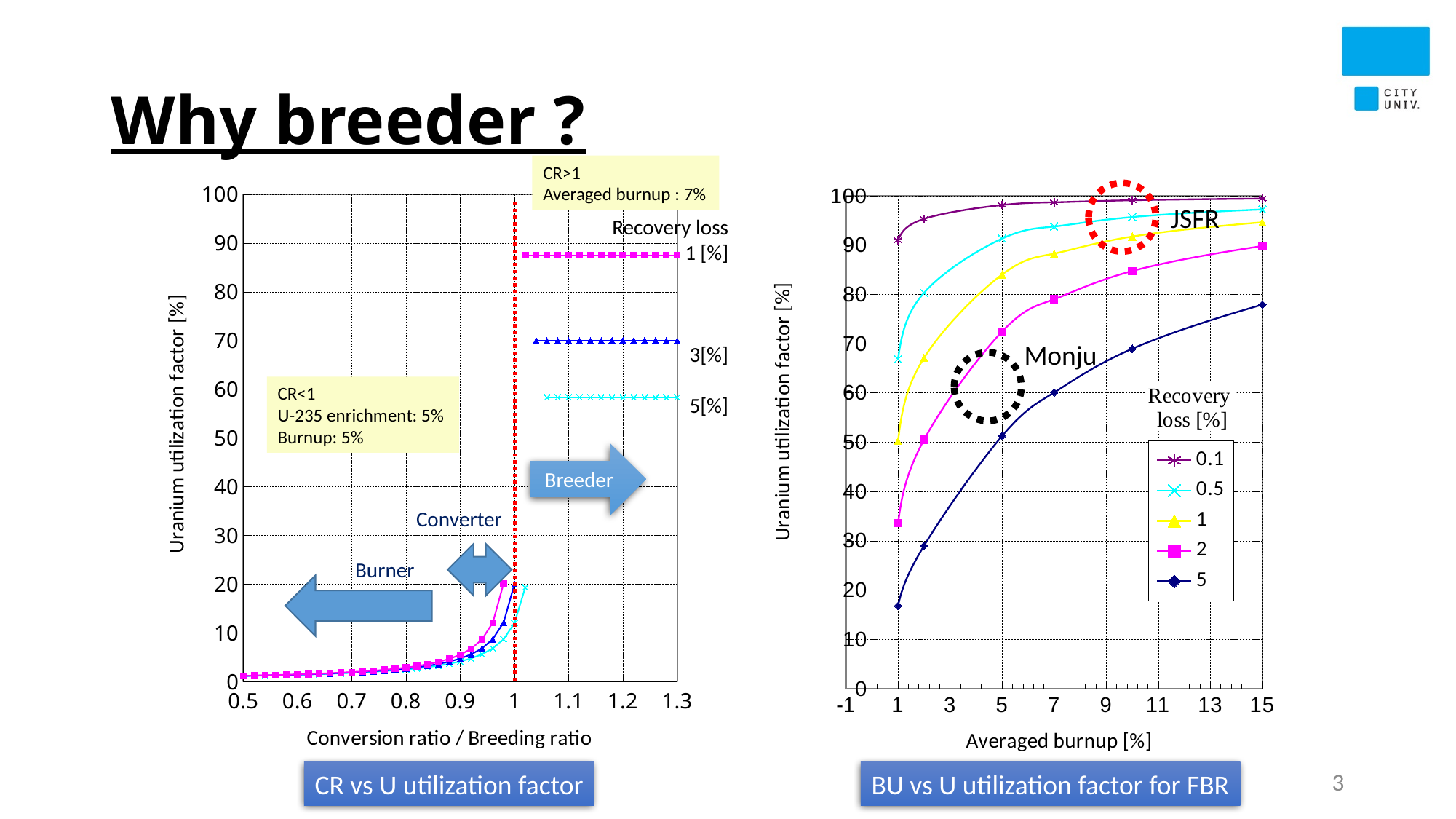
In the 'BU vs U utilization factor for FBR' chart, is the value for recovery loss 5 at an averaged burnup of 1% greater or less than 20? less In the 'BU vs U utilization factor for FBR' chart, is the value for recovery loss 5 at an averaged burnup of 15% greater or less than 70? greater In the 'CR vs U utilization factor' chart, is the uranium utilization factor for recovery loss 1 [%] in the breeder region (CR>1) greater or less than 80? greater What kind of chart is the 'CR vs U utilization factor' chart on the left? line chart In the 'CR vs U utilization factor' chart, how many recovery loss series are plotted? 3 What is the x-axis title of the 'CR vs U utilization factor' chart? Conversion ratio / Breeding ratio How many series does the legend of the 'BU vs U utilization factor for FBR' chart list? 5 In the 'BU vs U utilization factor for FBR' chart, at an averaged burnup of 5%, which series has the larger uranium utilization factor: recovery loss 0.5 or recovery loss 5? recovery loss 0.5 In the 'BU vs U utilization factor for FBR' chart, does the uranium utilization factor rise or fall as averaged burnup increases? rise Which two reactors are labelled with dashed circles on the 'BU vs U utilization factor for FBR' chart? JSFR and Monju